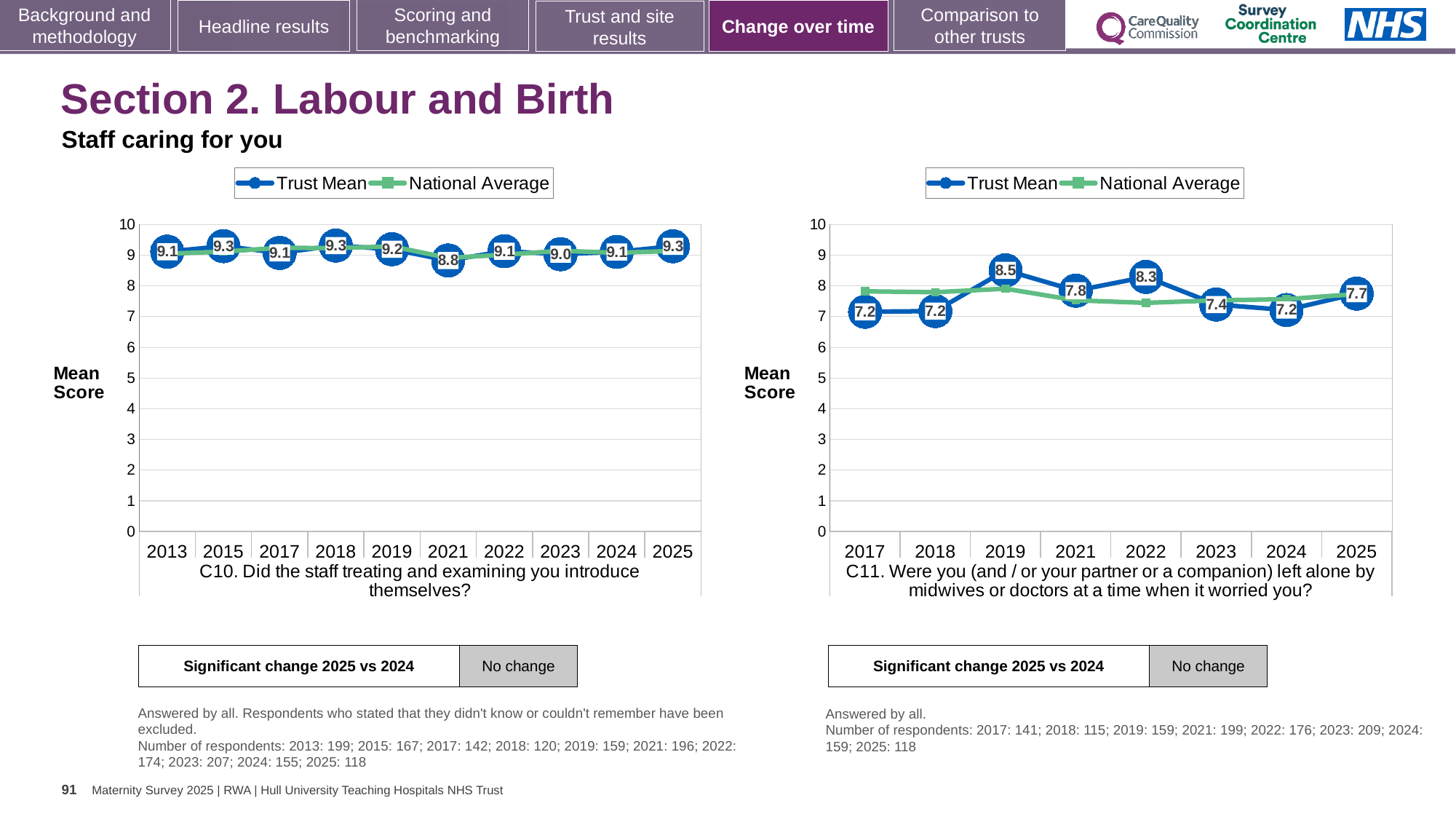
In the C10 chart on the left, what is the Trust Mean score for 2025? 9.3 In the C10 chart on the left, what is the difference between the Trust Mean scores for 2018 and 2021? 0.5 In the C11 chart on the right, what is the difference between the Trust Mean scores for 2019 and 2024? 1.3 How many series does the legend of the C11 chart on the right list? 2 In the C10 chart on the left, which year has the lowest Trust Mean score? 2021 What type of chart is the C10 chart on the left? Line chart In the C11 chart on the right, how many years are plotted on the x axis? 8 In the C11 chart on the right, which year has the highest Trust Mean score? 2019 In the C10 chart on the left, what is the Trust Mean score for 2021? 8.8 In the C10 chart on the left, how many years are plotted on the x axis? 10 In the C11 chart on the right, is the Trust Mean score for 2022 greater or less than the score for 2023? greater In the C11 chart on the right, what is the Trust Mean score for 2019? 8.5